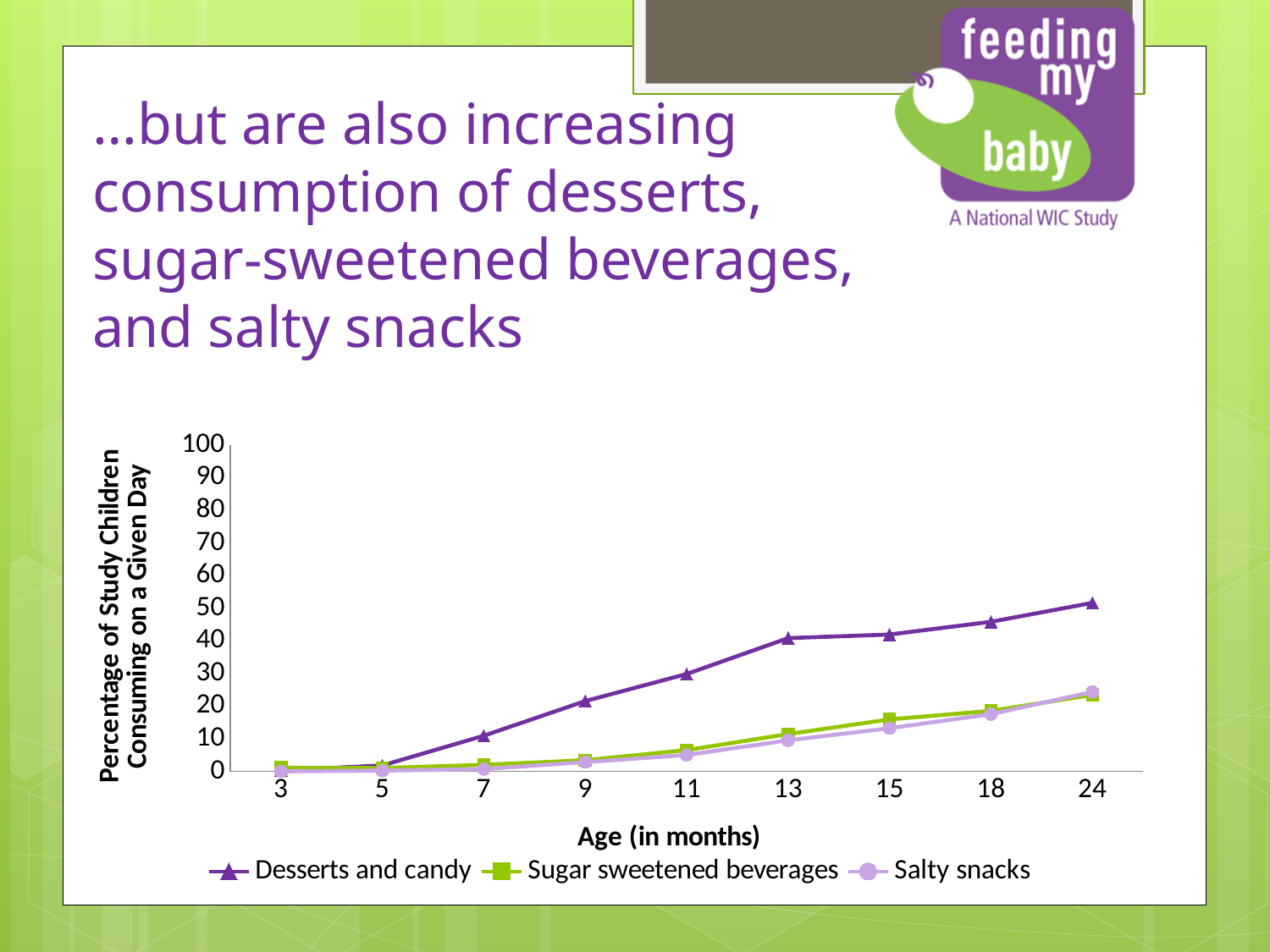
Do the values for Desserts and candy rise or fall as age increases from 3 to 24 months? rise Is the value for Sugar sweetened beverages at 24 months greater or less than 30? less Is the value for Desserts and candy at 24 months greater or less than 40? greater Which series has the highest value at 24 months? Desserts and candy At 13 months, which is larger: Desserts and candy or Sugar sweetened beverages? Desserts and candy What is the title of the x axis? Age (in months) Is the value for Salty snacks at 13 months greater or less than 20? less How many age points are plotted along the x axis? 9 What kind of chart is shown on the slide? Line chart How many series does the legend list? 3